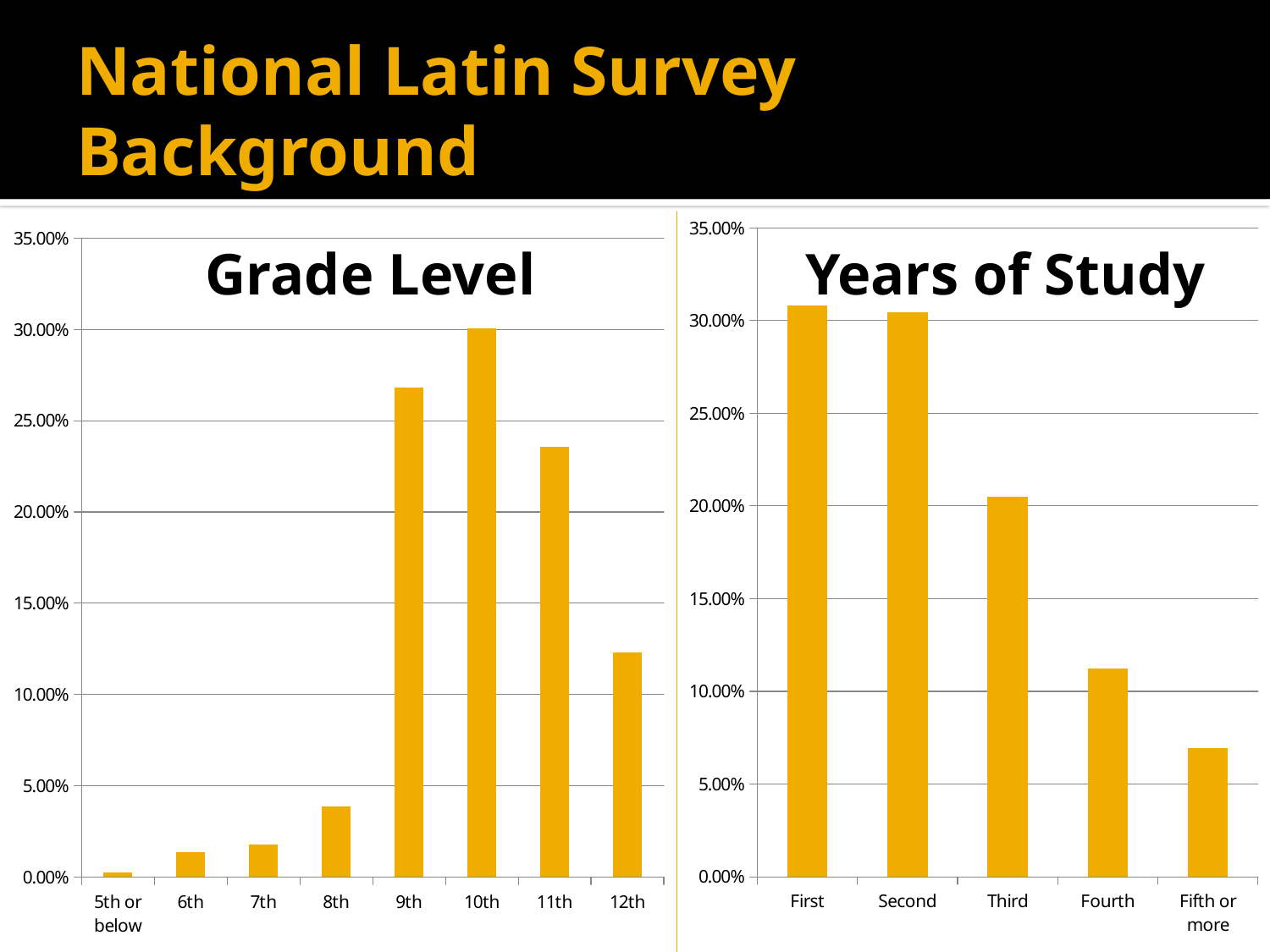
In the Grade Level chart, is the value for 8th greater or less than 5.00%? less In the Years of Study chart, which category has the lowest value? Fifth or more In the Grade Level chart, is the value for 12th greater or less than 10.00%? greater In the Grade Level chart, which is larger, the value for 9th or the value for 11th? 9th How many grade level categories are shown in the Grade Level chart? 8 In the Years of Study chart, is the value for Third greater or less than 20.00%? greater In the Years of Study chart, do the values rise or fall from First to Fifth or more? fall What kind of chart is the Years of Study chart? bar chart In the Grade Level chart, which category has the lowest value? 5th or below In the Grade Level chart, which grade level has the highest value? 10th